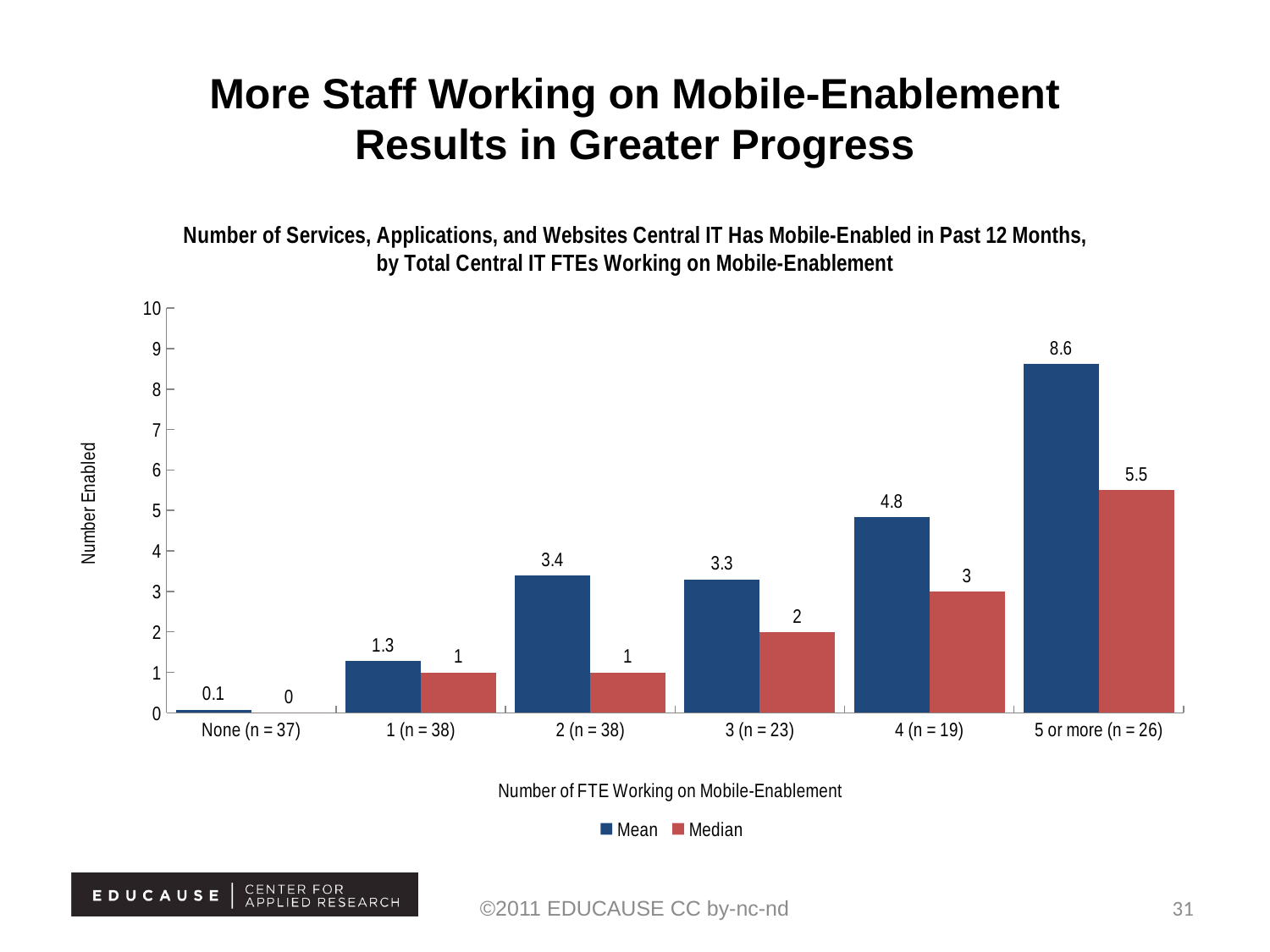
What is the Median value for the '4 (n = 19)' category? 3 How many categories are shown on the x axis? 6 How many series does the legend list? 2 Which category has the highest Mean value? 5 or more (n = 26) Which is larger, the Mean for '2 (n = 38)' or the Mean for '3 (n = 23)'? Mean for 2 (n = 38) Is the Mean value for '4 (n = 19)' greater or less than 4? greater What is the Mean value for the '2 (n = 38)' category? 3.4 What is the difference between the Mean and Median values for the '5 or more (n = 26)' category? 3.1 What is the Mean value for the '5 or more (n = 26)' category? 8.6 What is the label of the y axis? Number Enabled What kind of chart is shown on the slide? Bar chart Which category has the lowest Median value? None (n = 37)